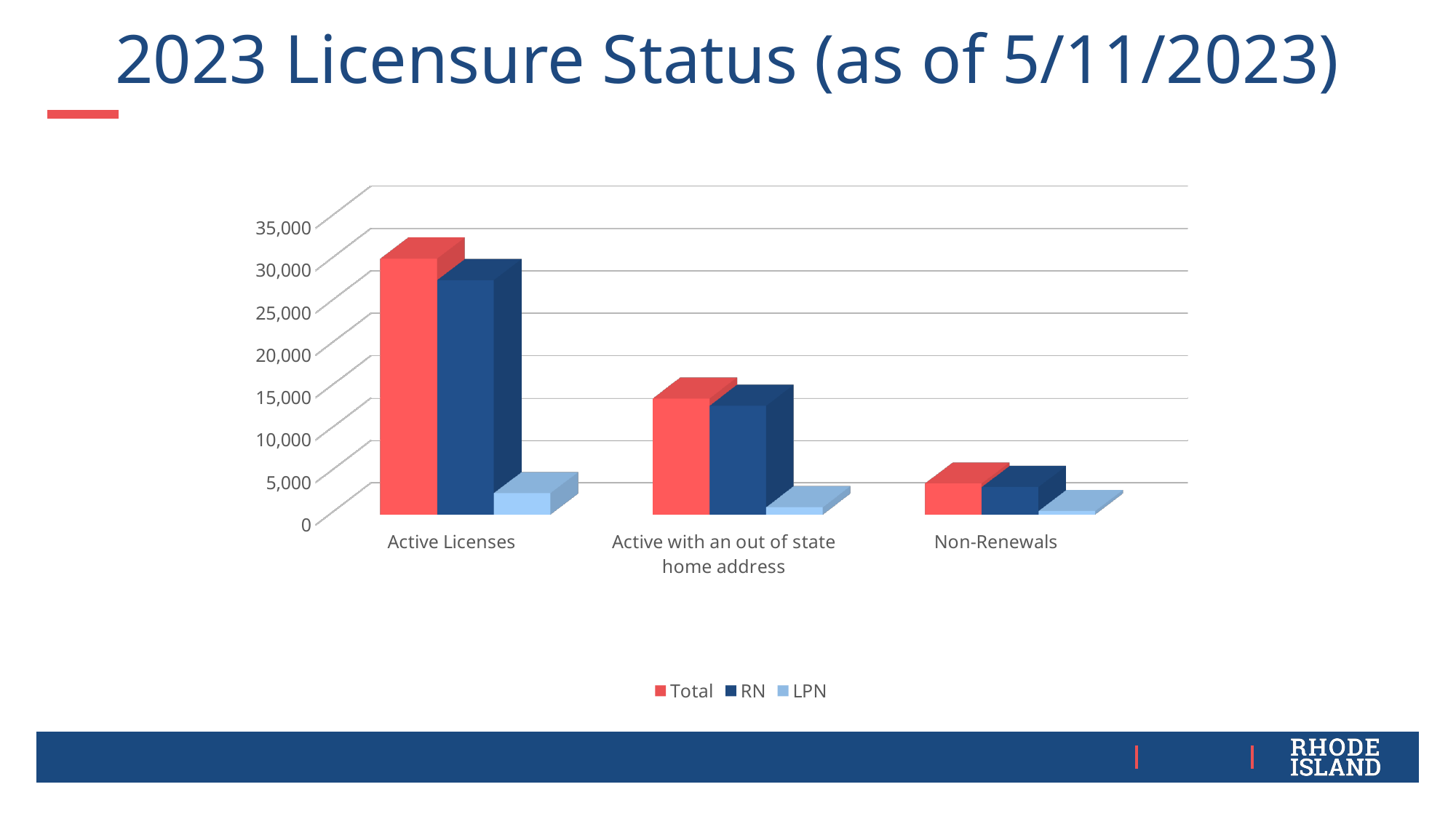
Do the Total values rise or fall moving from left to right across the categories? fall Is the LPN value for Active Licenses greater or less than 10,000? less What is the title of the slide containing the chart? 2023 Licensure Status (as of 5/11/2023) Which category has the lowest Total value? Non-Renewals How many series does the chart's legend list? 3 Is the Total value for Non-Renewals greater or less than 10,000? less Is the Total value for Active with an out of state home address greater or less than 10,000? greater Which is larger: the RN value for Active Licenses or the RN value for Non-Renewals? Active Licenses How many categories are shown on the x axis of the chart? 3 What kind of chart is shown on the slide? bar chart Which category has the highest Total value? Active Licenses